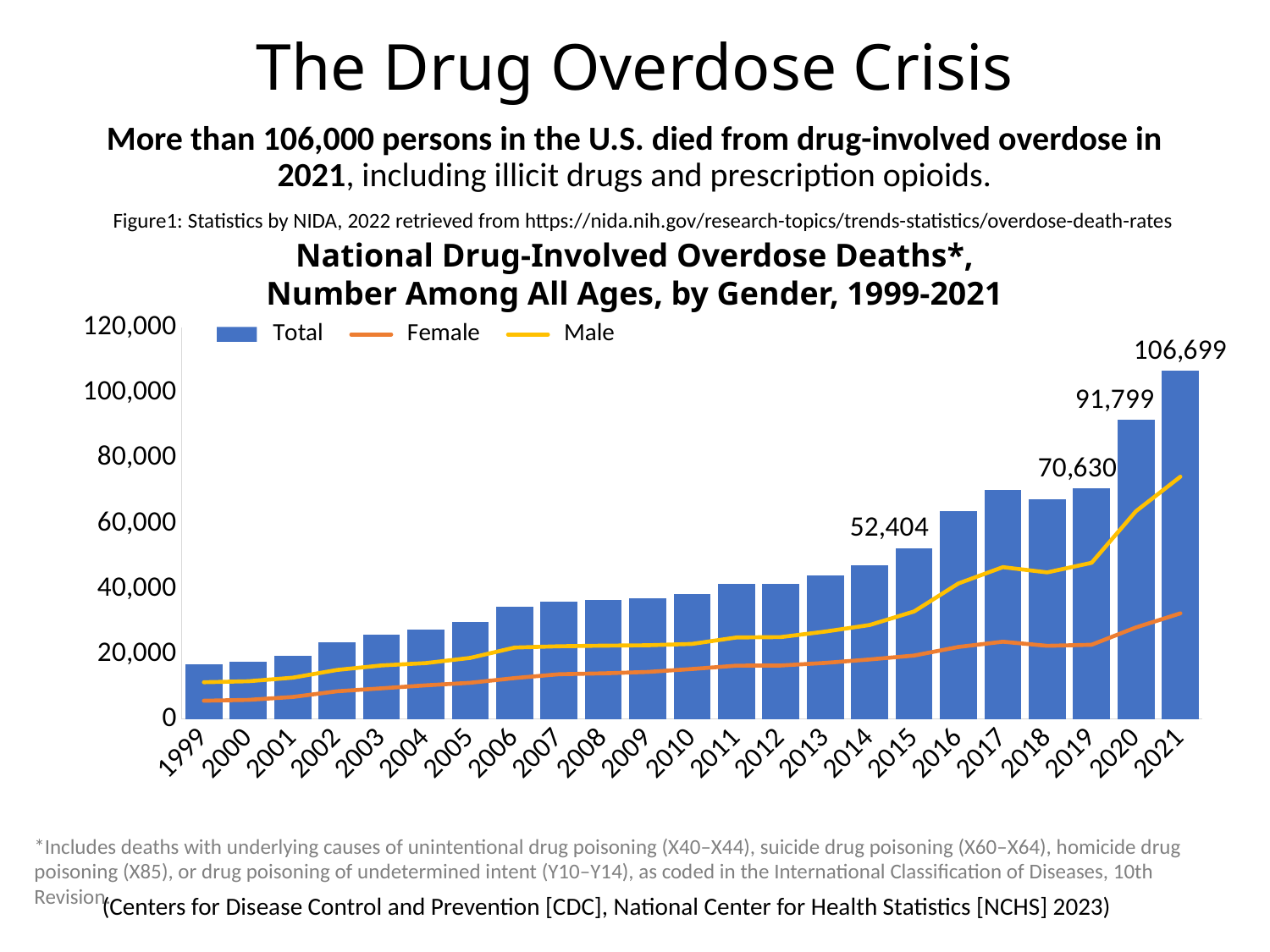
By how much did the total number of overdose deaths increase from 2020 to 2021? 14,900 What is the total number of overdose deaths labeled for 2015? 52,404 What is the difference between the total overdose deaths in 2020 and 2019? 21,169 How many series does the chart legend list? 3 What is the total number of overdose deaths labeled for 2019? 70,630 Is the total number of overdose deaths for 2013 greater or less than 40,000? greater What is the total number of overdose deaths labeled for 2020? 91,799 Which year has the highest total number of overdose deaths? 2021 In 2021, which series is higher, Male or Female? Male What is the total number of drug-involved overdose deaths shown for 2021? 106,699 Is the total number of overdose deaths for 1999 greater or less than 20,000? less How many years are shown on the x axis of the chart? 23